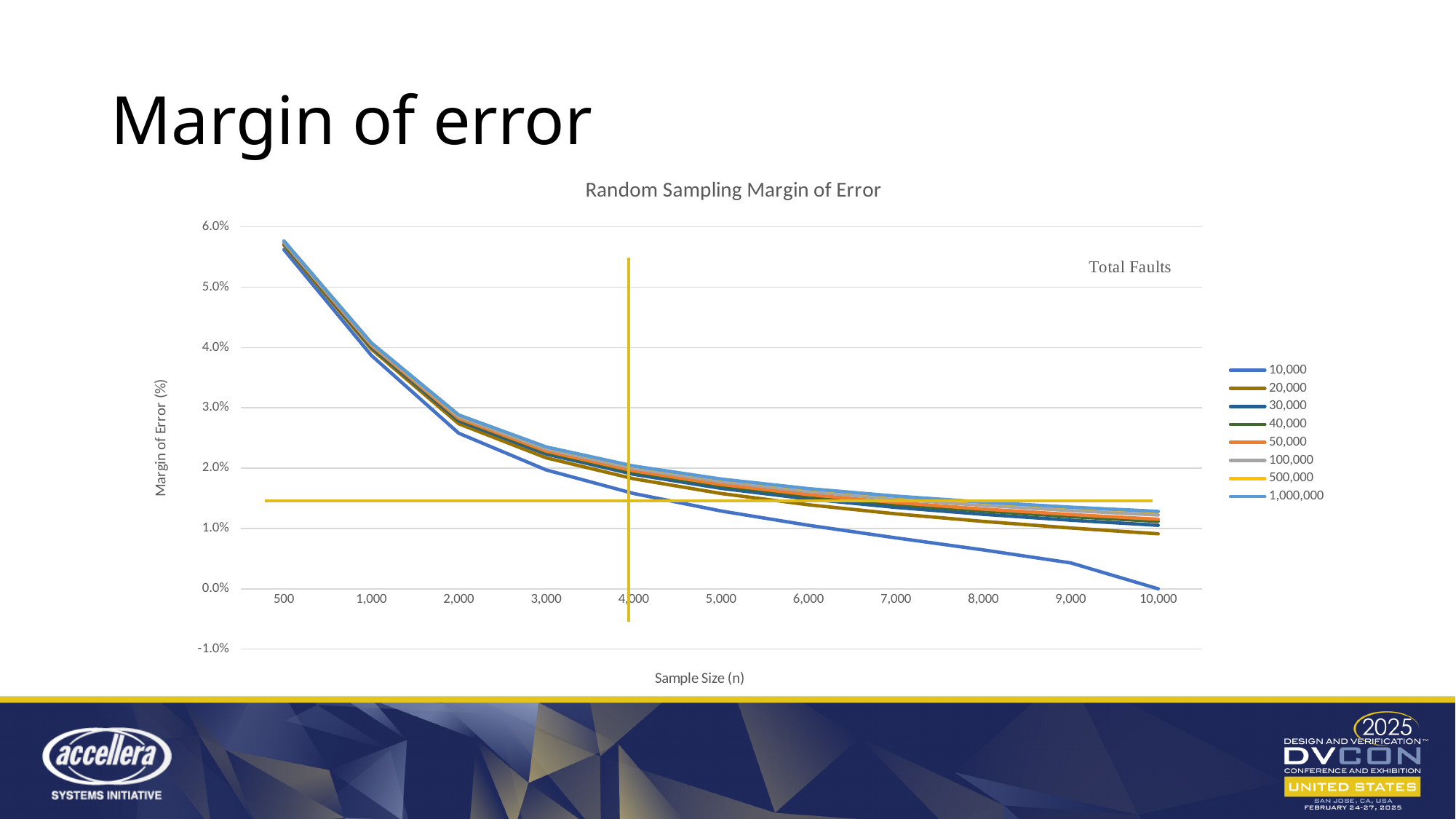
What is the title shown above the legend? Total Faults Which series has the lowest margin of error at a sample size of 10,000? 10,000 How many sample-size points are marked along the x axis? 11 How many series does the chart's legend list? 8 What is the margin of error for the 10,000 total faults series at a sample size of 10,000? 0.0% Is the margin of error for the 10,000 series at a sample size of 5,000 greater or less than 2.0%? less What is the title of the chart? Random Sampling Margin of Error At a sample size of 5,000, which series has the larger margin of error: 10,000 or 1,000,000? 1,000,000 Is the margin of error for the 10,000 series at a sample size of 9,000 greater or less than 1.0%? less Does the margin of error rise or fall as the sample size increases? fall Is the margin of error for the 1,000,000 series at a sample size of 500 greater or less than 5.0%? greater What kind of chart is shown on the slide? line chart